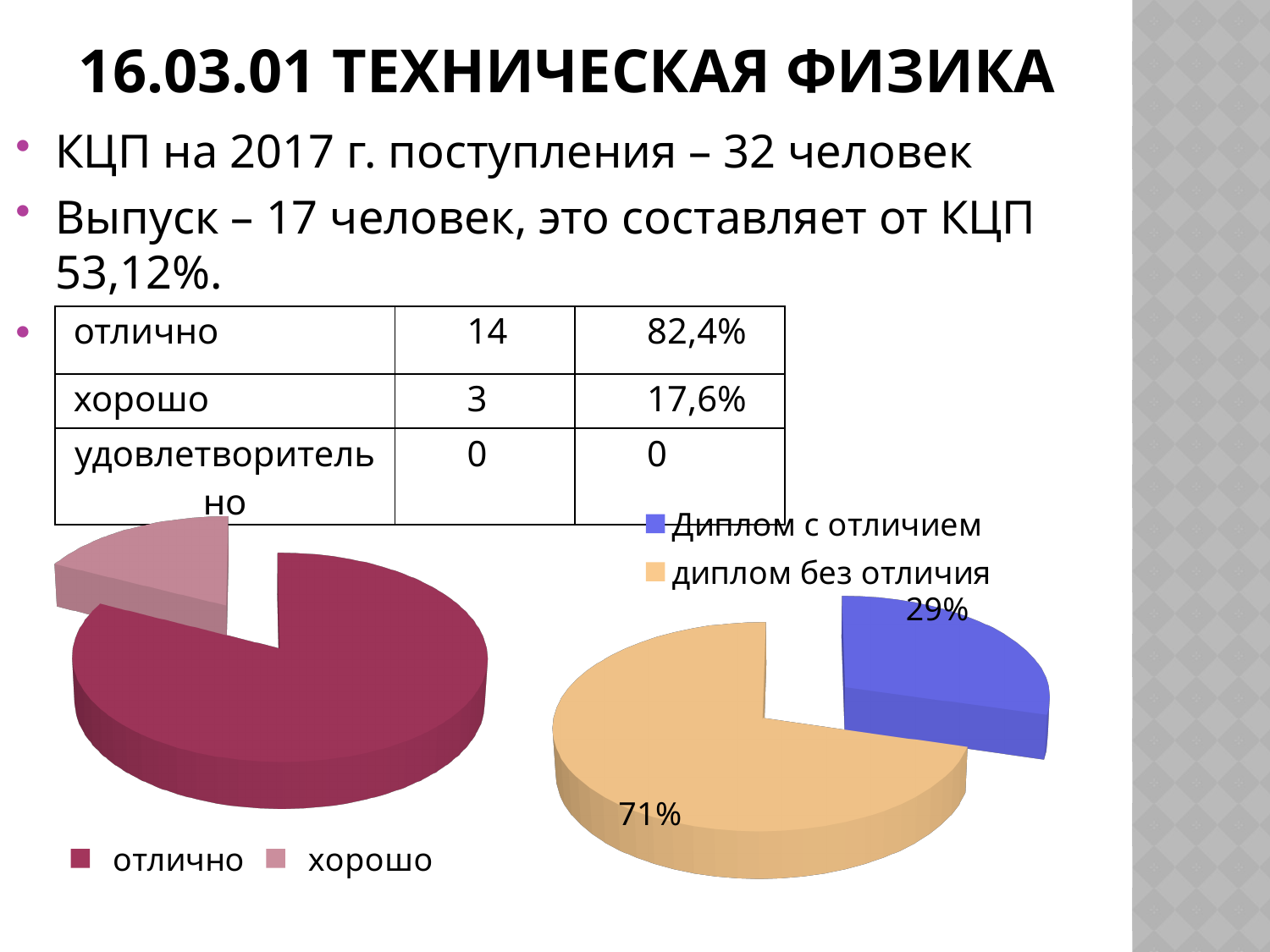
How many categories are shown in the left pie chart? 2 In the right pie chart, what share is shown for "диплом без отличия"? 71% In the right pie chart, which slice is larger: "Диплом с отличием" or "диплом без отличия"? диплом без отличия In the right pie chart, what share is shown for "Диплом с отличием"? 29% In the left pie chart, what colour is the "отлично" slice? dark red In the right pie chart, what colour is the "Диплом с отличием" slice? blue In the left pie chart, which category has the largest slice? отлично How many entries does the legend of the right chart list? 2 What kind of chart is the right chart on the slide? pie chart In the left pie chart, which category has the smallest slice? хорошо In the right pie chart, what is the difference in percentage points between "диплом без отличия" and "Диплом с отличием"? 42% What kind of chart is the left chart on the slide? pie chart